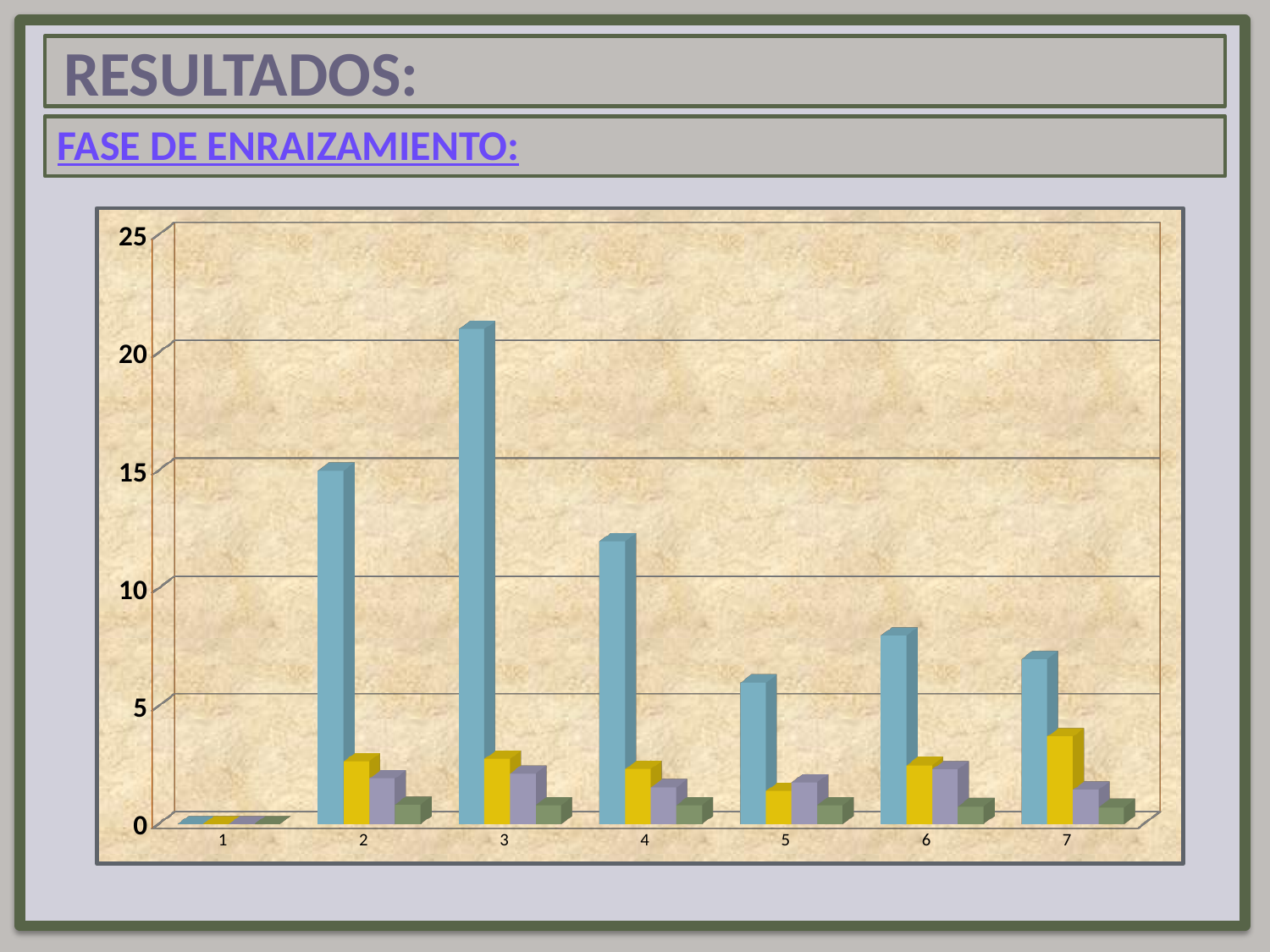
Which has the larger blue bar, category 2 or category 5? 2 Do the blue bars rise or fall from category 3 to category 5? fall How many categories are shown along the x axis of the chart? 7 What kind of chart is shown on the slide? bar chart Is the blue bar for category 3 greater or less than 20? greater Is the blue bar for category 6 greater or less than 5? greater Is the blue bar for category 5 greater or less than 10? less For the blue series, which category has the highest bar? 3 What is the highest value shown on the vertical axis of the chart? 25 How many bars are plotted for each category in the chart? 4 For the blue series, which category has the lowest bar? 1